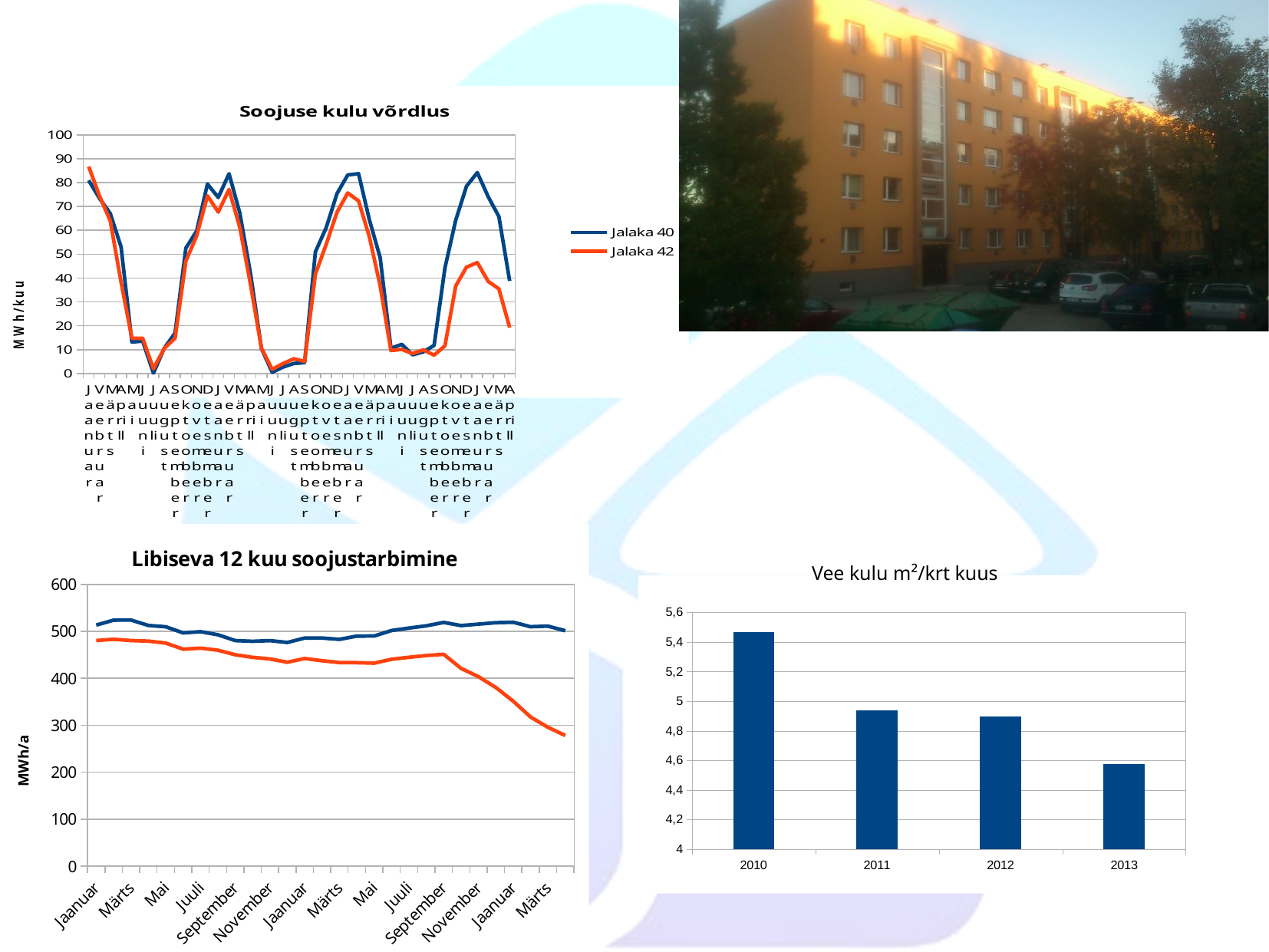
In the "Vee kulu m²/krt kuus" chart, which is larger, the value for 2010 or the value for 2013? 2010 In the "Vee kulu m²/krt kuus" chart, do the values generally rise or fall from 2010 to 2013? fall In the "Vee kulu m²/krt kuus" chart, which year has the lowest value? 2013 What are the two series named in the legend of the "Soojuse kulu võrdlus" chart? Jalaka 40 and Jalaka 42 In the "Vee kulu m²/krt kuus" chart, is the value for 2011 greater or less than 5? less What kind of chart is "Vee kulu m²/krt kuus"? bar chart In the "Vee kulu m²/krt kuus" chart, how many years are shown? 4 In the "Vee kulu m²/krt kuus" chart, which year has the highest value? 2010 In the "Vee kulu m²/krt kuus" chart, is the value for 2010 greater or less than 5,4? greater What kind of chart is "Soojuse kulu võrdlus"? line chart How many series does the legend of the "Soojuse kulu võrdlus" chart list? 2